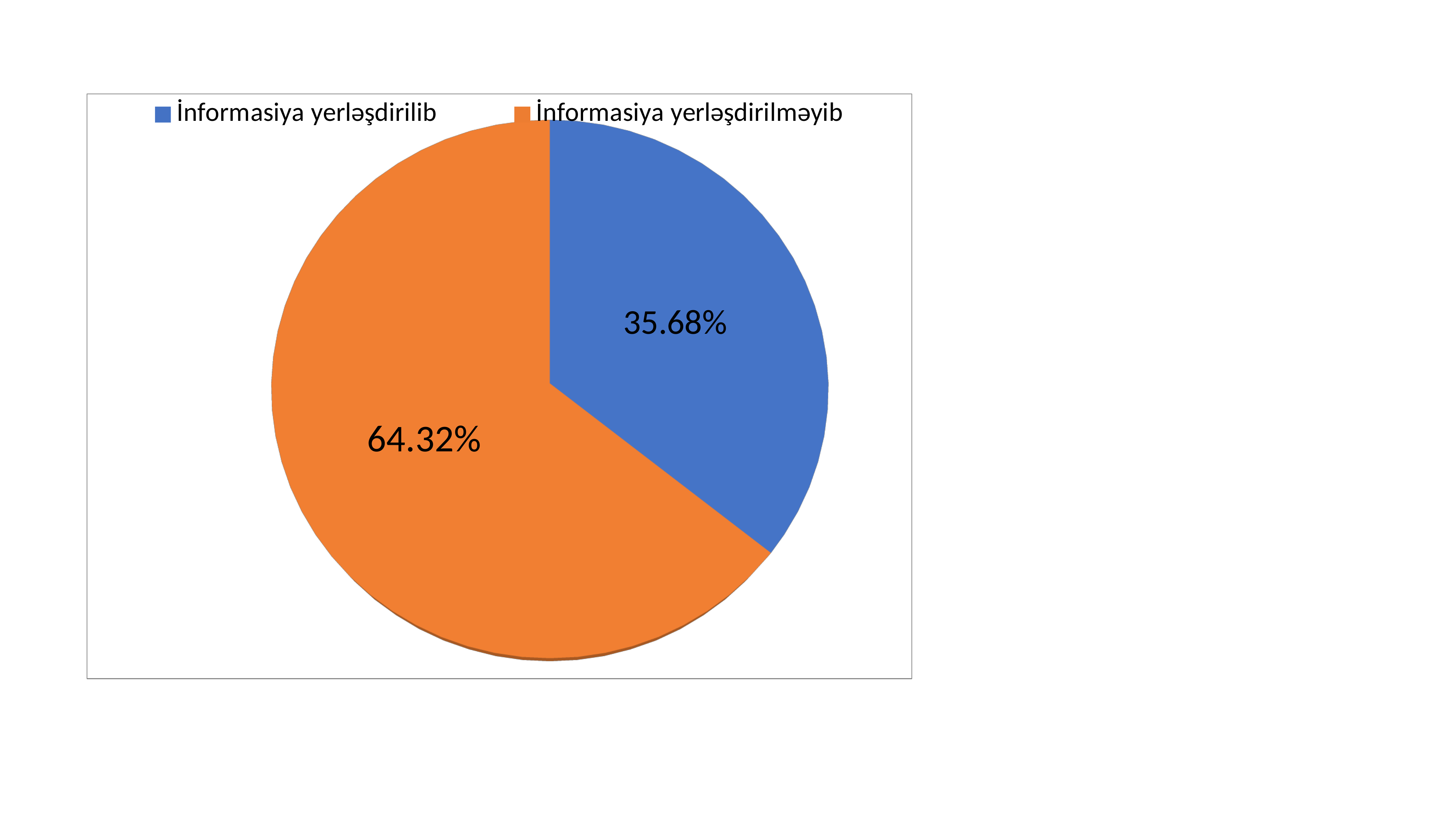
What is the difference between the shares of "İnformasiya yerləşdirilməyib" and "İnformasiya yerləşdirilib"? 28.64% What share of the pie does "İnformasiya yerləşdirilməyib" have? 64.32% What share of the pie does "İnformasiya yerləşdirilib" have? 35.68% What colour is the slice for "İnformasiya yerləşdirilməyib"? orange Which slice is the largest? İnformasiya yerləşdirilməyib How many entries does the legend list? 2 What kind of chart is shown on the slide? pie chart Which slice is the smallest? İnformasiya yerləşdirilib How many slices does the pie chart have? 2 Which is larger: the share for "İnformasiya yerləşdirilib" or for "İnformasiya yerləşdirilməyib"? İnformasiya yerləşdirilməyib What colour is the slice for "İnformasiya yerləşdirilib"? blue